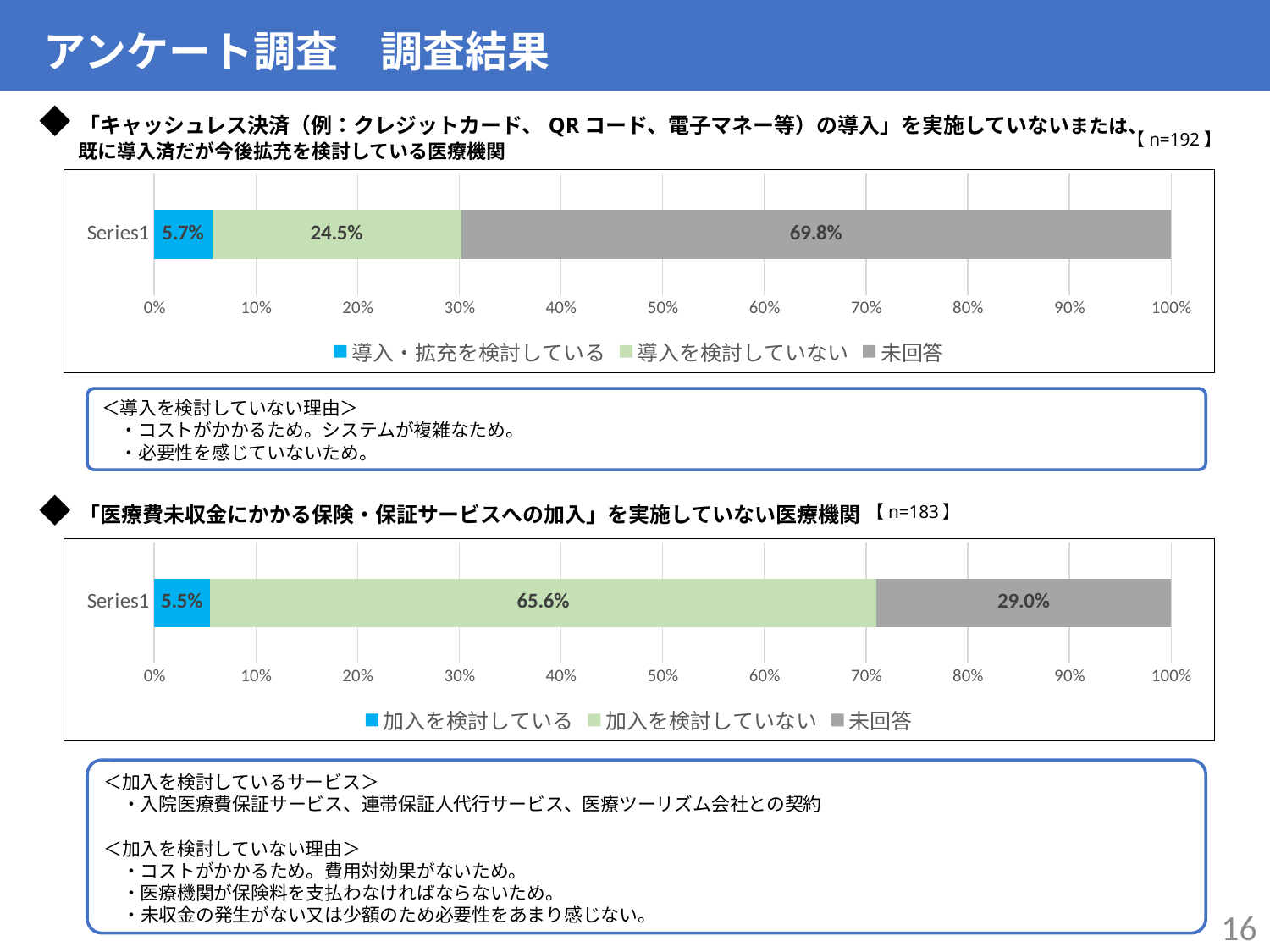
In the bottom chart, what colour is the 未回答 segment? Gray In the top chart, what is the value for 未回答? 69.8% In the bottom chart, what is the total of the three segments of the stacked bar? 100.1% In the top chart, which segment has the largest value? 未回答 In the top chart, what is the value for 導入・拡充を検討している? 5.7% In the bottom chart, which segment has the smallest value? 加入を検討している In the top chart, how many series does the legend list? 3 In the bottom chart, which is larger, 加入を検討していない or 未回答? 加入を検討していない What kind of chart is the top chart? Stacked bar chart In the bottom chart, what is the value for 加入を検討していない? 65.6% In the bottom chart, what is the value for 未回答? 29.0% In the top chart, what is the difference between 未回答 and 導入を検討していない? 45.3%